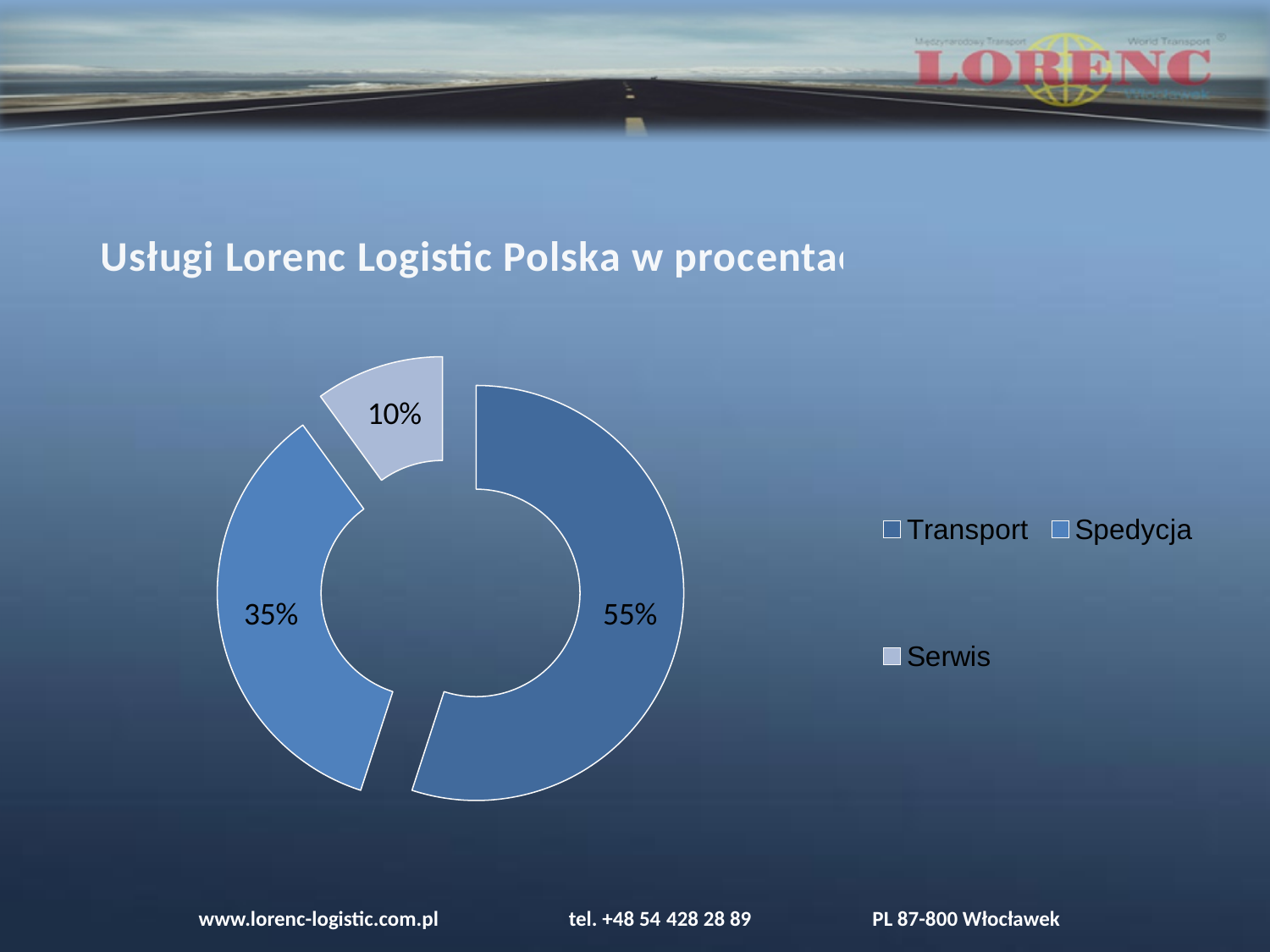
What is the difference in percentage points between Transport and Spedycja? 20 What percentage does the Transport segment represent? 55% What percentage does the Serwis segment represent? 10% Which is larger, the Spedycja share or the Serwis share? Spedycja How many segments does the chart have? 3 What is the difference in percentage points between Spedycja and Serwis? 25 What kind of chart is shown on the slide? Doughnut chart What percentage does the Spedycja segment represent? 35% Which legend entry is shown in the lightest colour? Serwis Which segment has the smallest share? Serwis How many entries does the legend list? 3 Which segment has the largest share? Transport